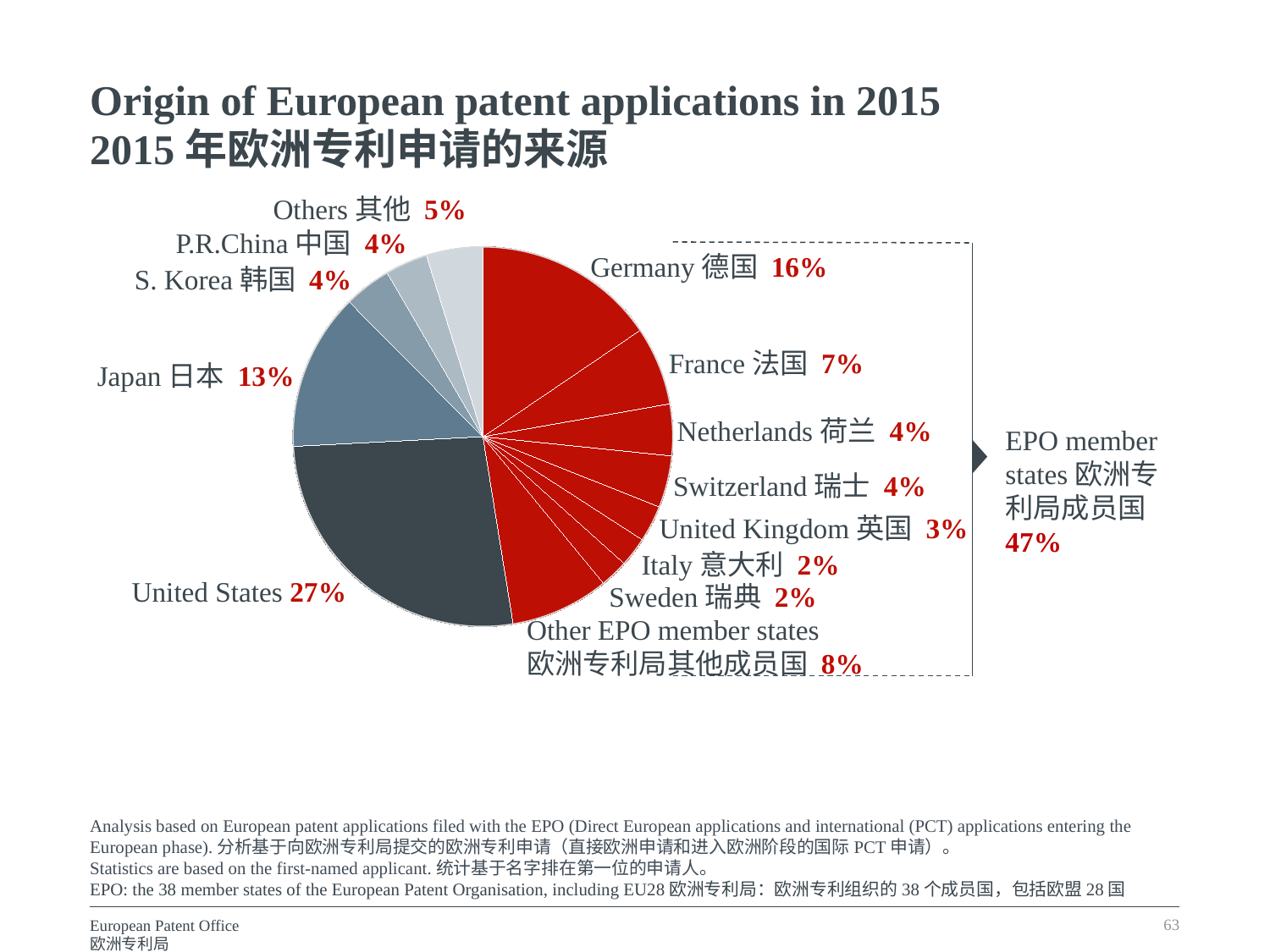
What share of European patent applications in 2015 came from Germany? 16% Which is larger, the share for France or the share for the United Kingdom? France What combined share is shown for the EPO member states? 47% Which single country has the largest slice of the pie? United States What is the difference between the United States share and the Japan share? 14% What share of European patent applications in 2015 came from Japan? 13% What kind of chart is shown on the slide? Pie chart What share is labelled for Other EPO member states? 8% What share of European patent applications in 2015 came from the United States? 27% What is the title of the chart on the slide? Origin of European patent applications in 2015 How many slices does the pie chart have? 13 What is the difference between the Germany share and the France share? 9%